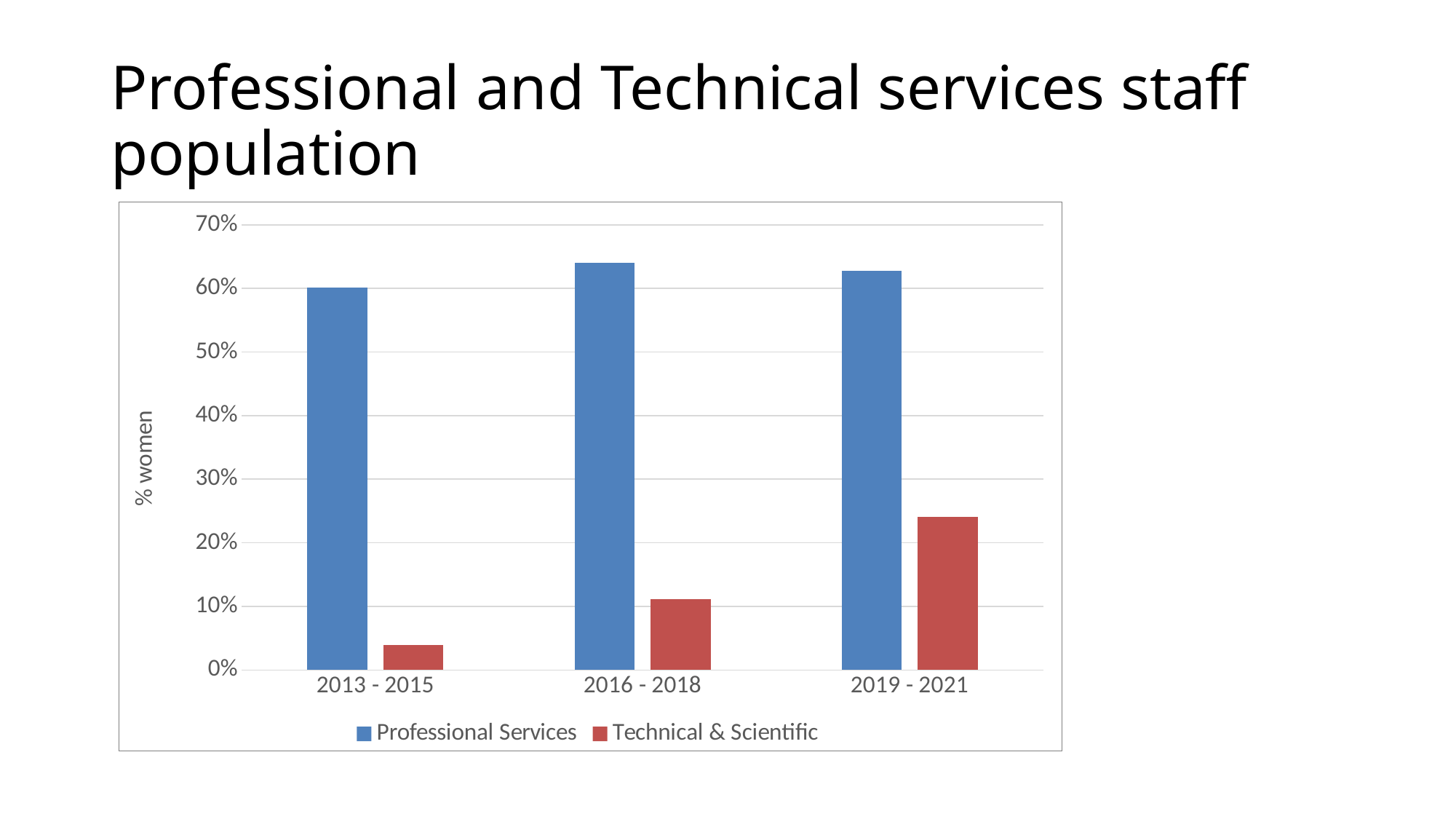
Do the Technical & Scientific values rise or fall from 2013 - 2015 to 2019 - 2021? Rise Is the value for Professional Services in 2016 - 2018 greater or less than 60%? greater Which period has the highest value for Technical & Scientific? 2019 - 2021 Is the value for Technical & Scientific in 2019 - 2021 greater or less than 20%? greater What is the label on the vertical axis? % women How many time periods are shown on the x axis? 3 Which period has the lowest value for Professional Services? 2013 - 2015 How many series does the legend list? 2 Which period has the lowest value for Technical & Scientific? 2013 - 2015 What kind of chart is shown on the slide? Bar chart Is the value for Technical & Scientific in 2013 - 2015 greater or less than 10%? less In 2019 - 2021, which series has the larger value, Professional Services or Technical & Scientific? Professional Services